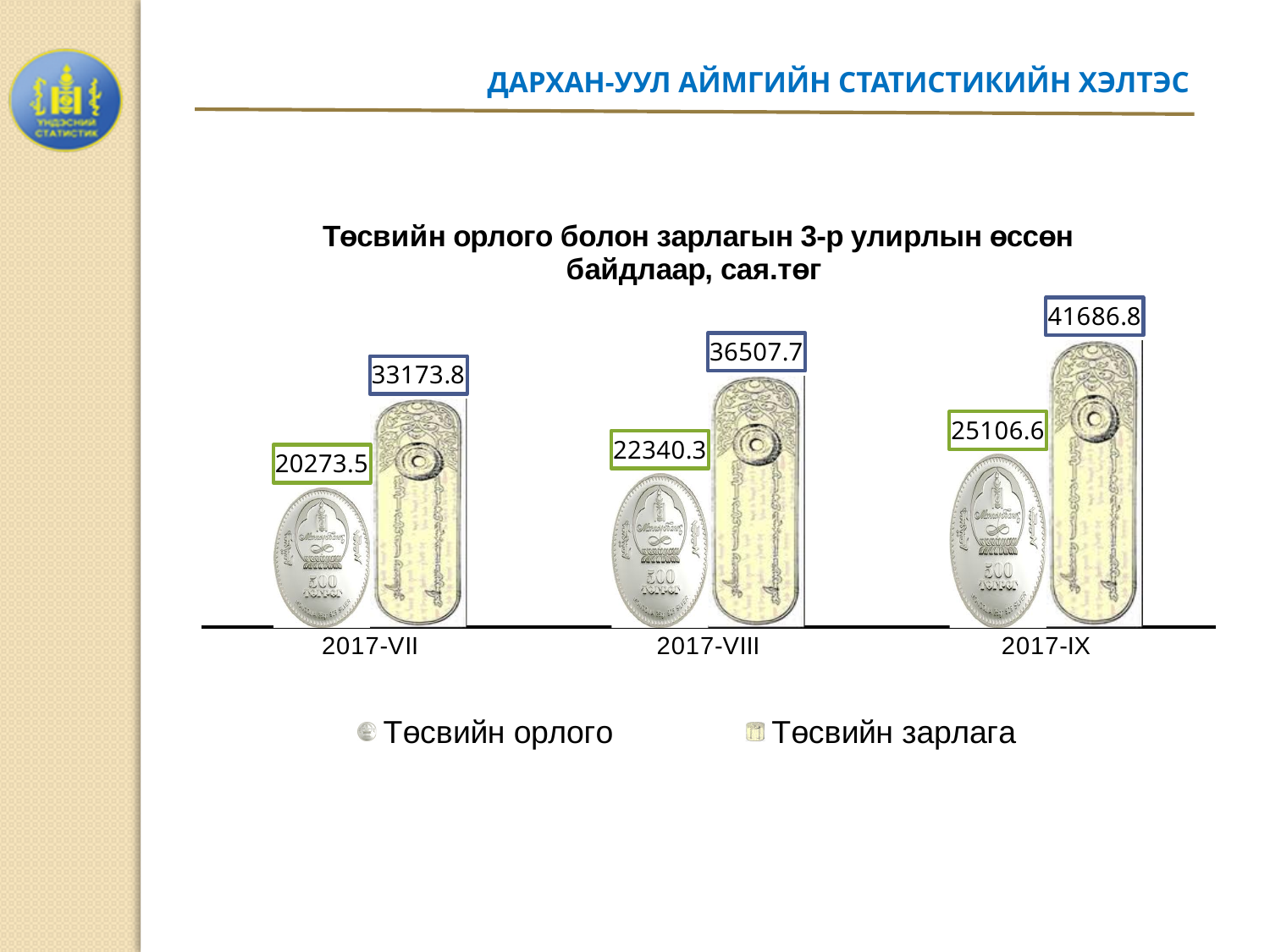
What is the value of Төсвийн орлого for 2017-VII? 20273.5 What is the value of Төсвийн орлого for 2017-IX? 25106.6 What is the value of Төсвийн зарлага for 2017-VIII? 36507.7 Does Төсвийн зарлага rise or fall from 2017-VII to 2017-IX? rise What is the difference between Төсвийн зарлага and Төсвийн орлого in 2017-VII? 12900.3 How many periods are shown on the x axis? 3 In which period is Төсвийн орлого lowest? 2017-VII By how much did Төсвийн орлого increase from 2017-VII to 2017-IX? 4833.1 What is the value of Төсвийн зарлага for 2017-IX? 41686.8 Which is larger in 2017-VIII, Төсвийн орлого or Төсвийн зарлага? Төсвийн зарлага In which period is Төсвийн зарлага highest? 2017-IX How many series does the legend list? 2